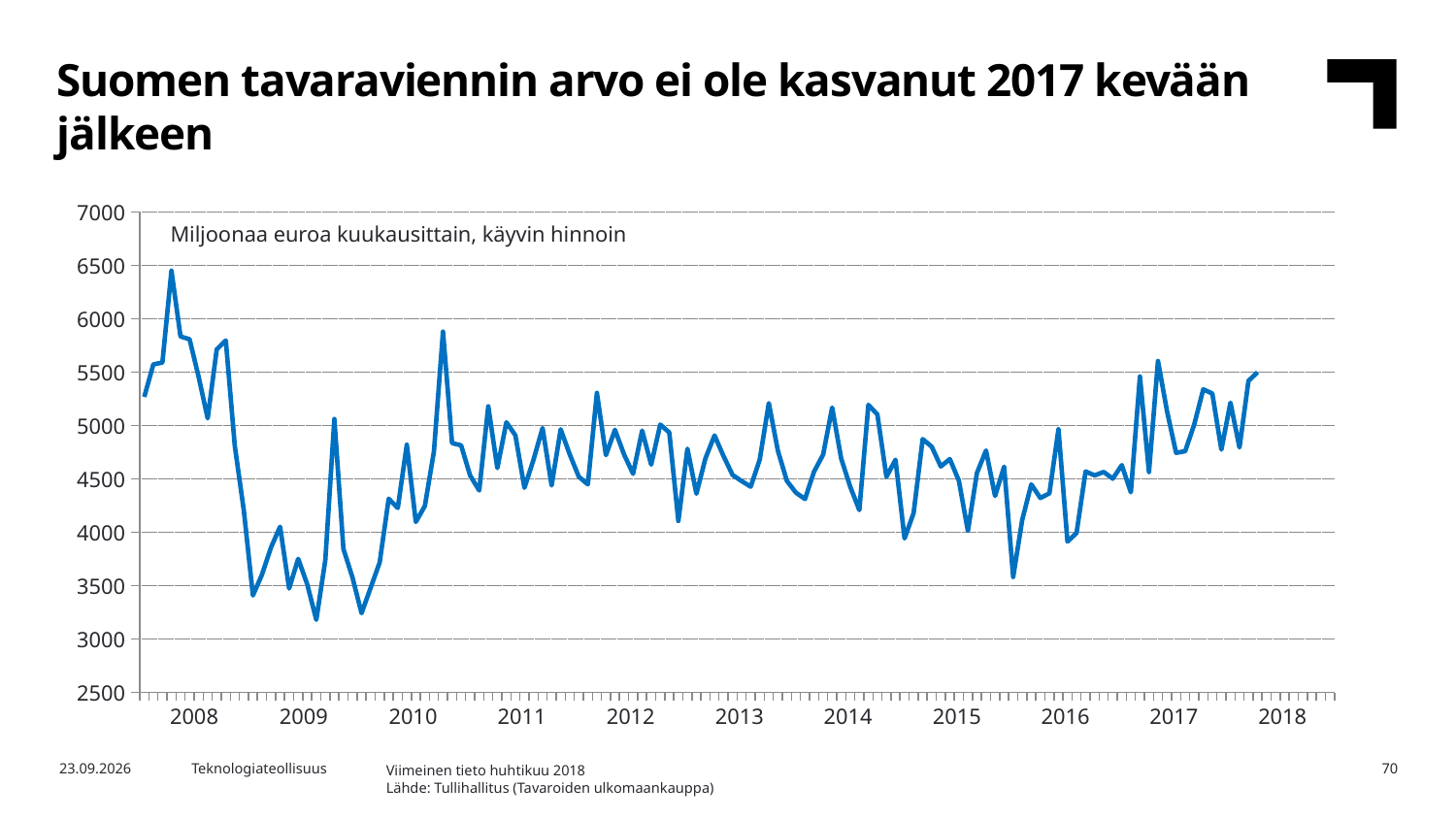
Do the values rise or fall from the start of 2008 to the start of 2009? fall What is the title of the slide? Suomen tavaraviennin arvo ei ole kasvanut 2017 kevään jälkeen Is the lowest value reached in 2009 greater or less than 3500? less How many lines are plotted on the chart? 1 Is the highest value reached in 2008 greater or less than 6000? greater What unit label is printed inside the chart area? Miljoonaa euroa kuukausittain, käyvin hinnoin Is the peak value in 2010 greater or less than 5500? greater What kind of chart is shown on the slide? line chart Which is higher: the peak value in 2008 or the peak value in 2017? 2008 How many year labels are shown on the x axis? 11